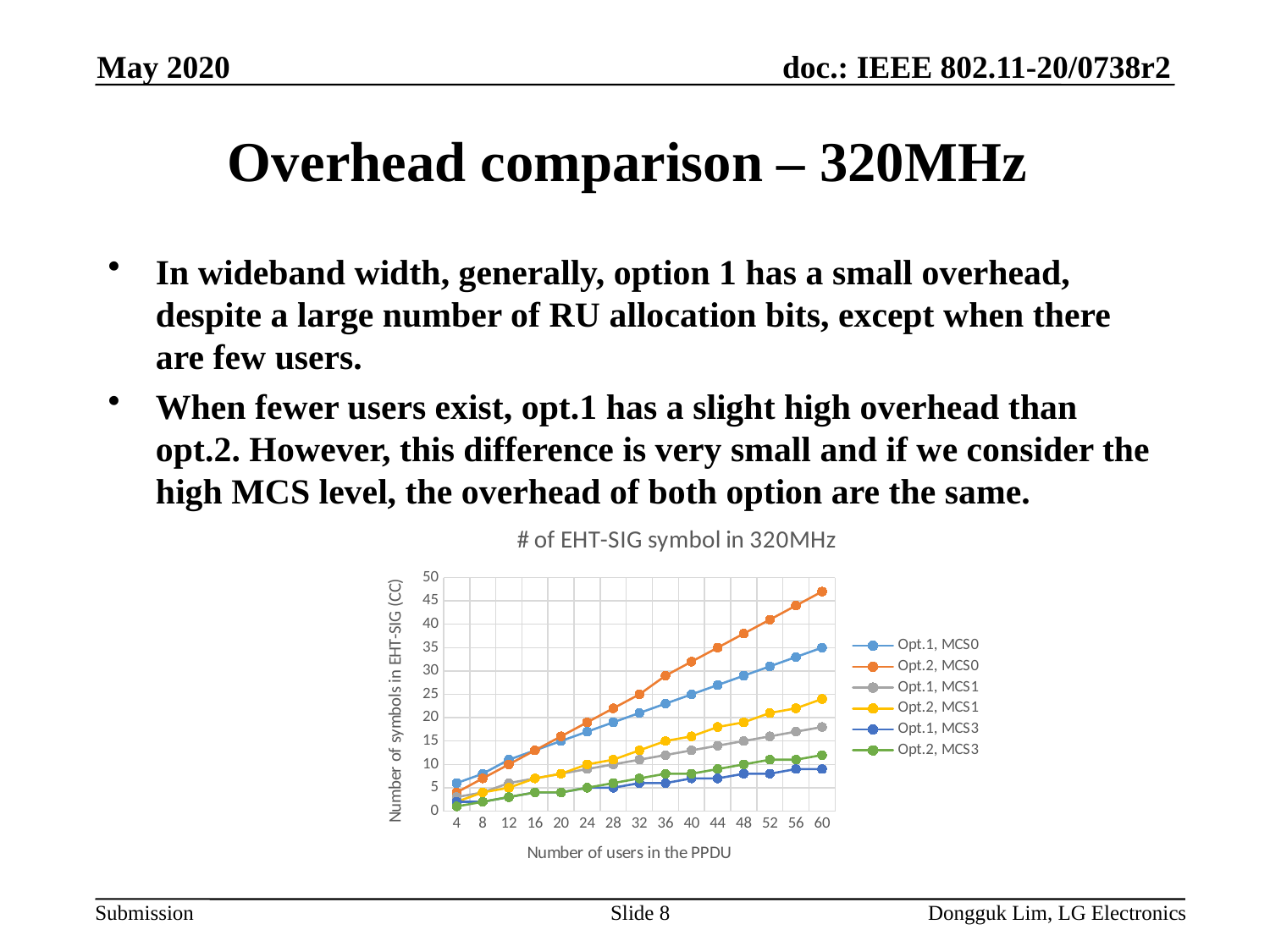
What is the label of the y axis of the chart? Number of symbols in EHT-SIG (CC) At 60 users, which is larger: the value for 'Opt.2, MCS0' or the value for 'Opt.1, MCS0'? Opt.2, MCS0 What kind of chart is shown on the slide? line chart At 40 users, is the value for 'Opt.2, MCS0' greater or less than 30? greater At 60 users, is the value for 'Opt.2, MCS0' greater or less than 45? greater How many values of 'Number of users in the PPDU' are shown on the x axis of the chart? 15 Which series has the lowest value at 60 users in the PPDU? Opt.1, MCS3 Do the values of the 'Opt.2, MCS0' series rise or fall as the number of users increases? rise How many series does the legend of the chart list? 6 Which series has the highest value at 60 users in the PPDU? Opt.2, MCS0 At 60 users, is the value for 'Opt.1, MCS3' greater or less than 15? less What is the title of the chart? # of EHT-SIG symbol in 320MHz